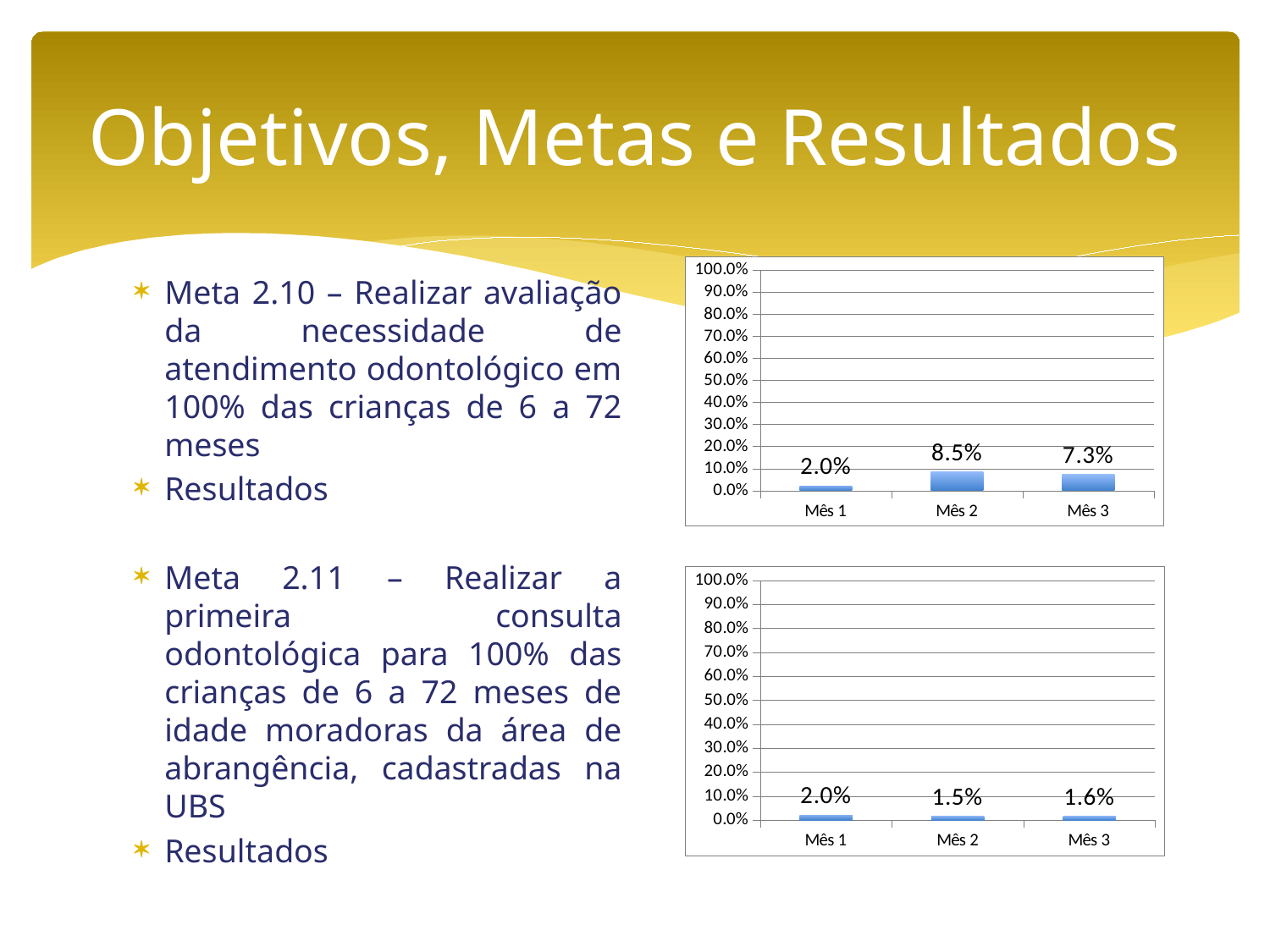
In the top chart, what is the value for Mês 3? 7.3% In the bottom chart, what is the value for Mês 1? 2.0% How many categories are shown on the x axis of the bottom chart? 3 In the bottom chart, which month has the highest value? Mês 1 In the top chart, what is the difference between the values for Mês 2 and Mês 1? 6.5% What kind of chart is the top chart? bar chart In the top chart, is the value for Mês 2 greater or less than 10.0%? less In the top chart, which month has the highest value? Mês 2 In the top chart, which month has the lowest value? Mês 1 In the top chart, what is the value for Mês 2? 8.5% In the bottom chart, what is the difference between the values for Mês 1 and Mês 3? 0.4% In the bottom chart, what is the value for Mês 2? 1.5%